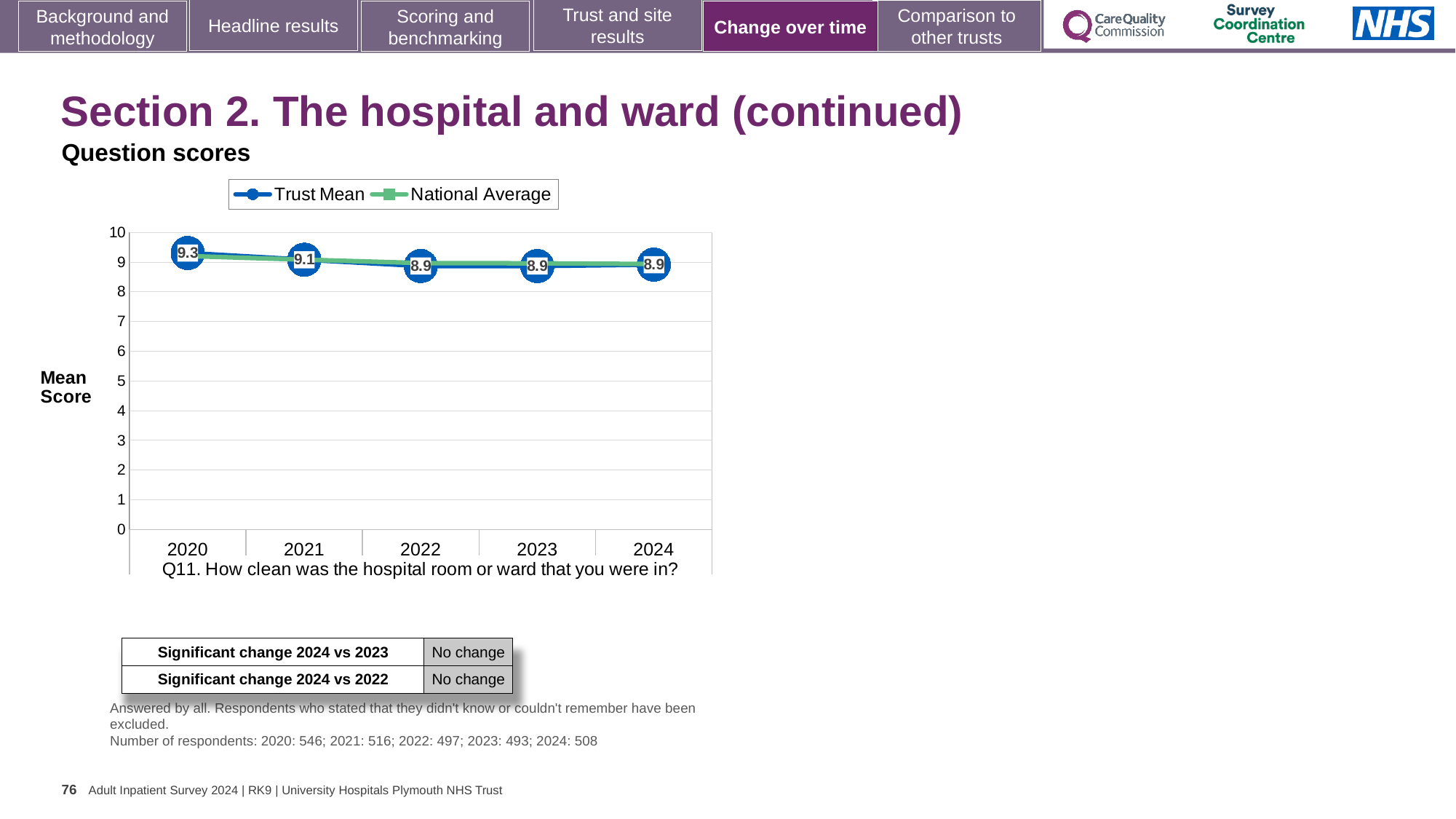
In which year is the Trust Mean highest? 2020 What is the Trust Mean value for 2021? 9.1 How many series does the legend list? 2 What kind of chart is shown? Line chart What question is the chart about, as labelled below the x axis? Q11. How clean was the hospital room or ward that you were in? What is the difference between the Trust Mean in 2020 and in 2024? 0.4 Is the National Average value for 2024 greater or less than 8? greater What is the Trust Mean value for 2024? 8.9 How many years are shown on the x axis? 5 Which is larger, the Trust Mean for 2020 or for 2022? 2020 Does the Trust Mean rise or fall from 2020 to 2024? Fall What is the Trust Mean value for 2020? 9.3